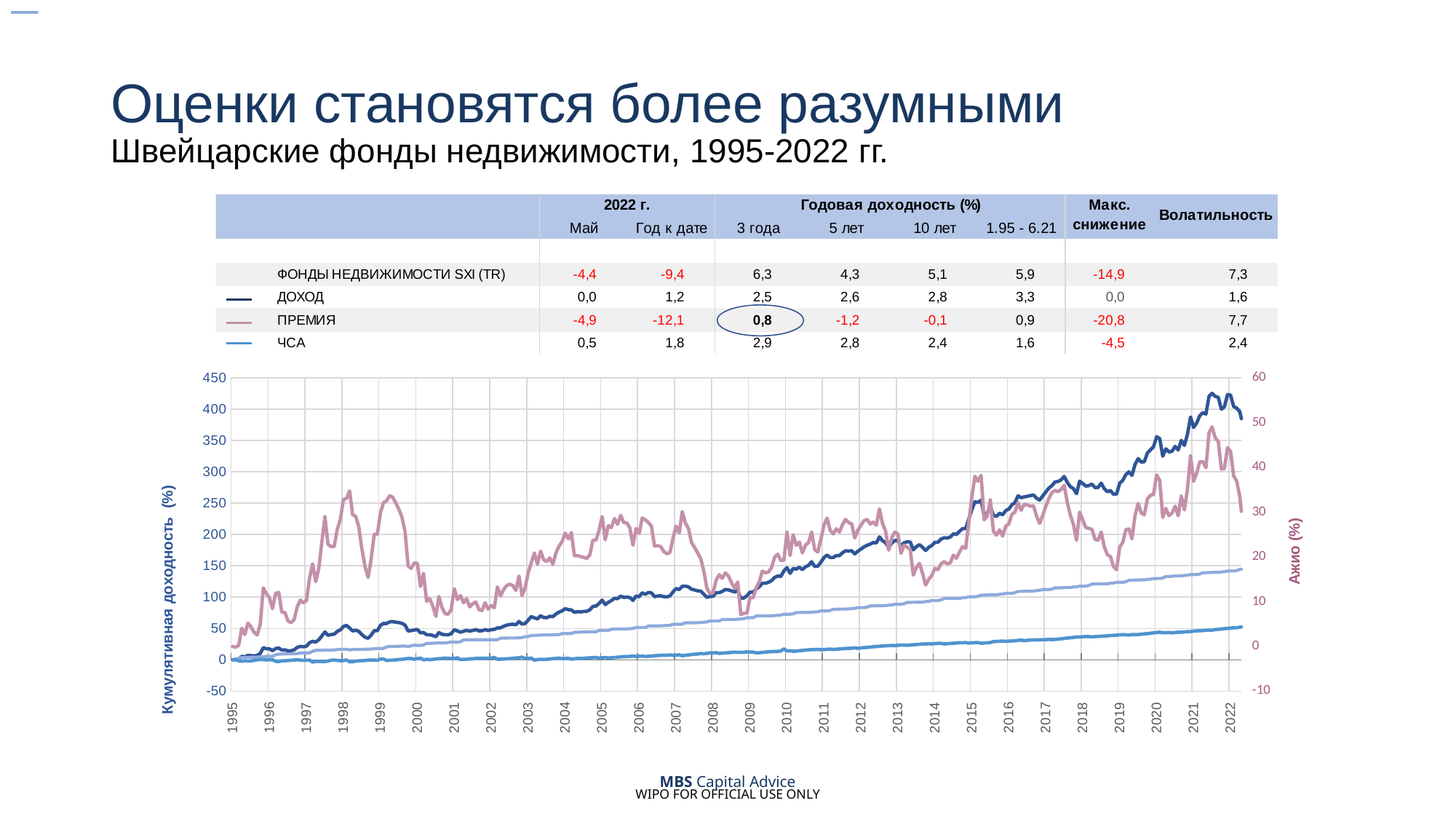
What is the title of the right vertical axis of the chart? Ажио (%) What is the highest tick value shown on the left vertical axis of the chart? 450 In the table, what is the maximum drawdown (Макс. снижение) for ПРЕМИЯ? -20,8 Is the value of the light blue ЧСА line in 2022 greater or less than 100 on the left axis? less What kind of chart is shown on the slide? line chart Is the peak value of the dark blue ДОХОД line around 2021 greater or less than 400 on the left axis? greater What is the title of the left vertical axis of the chart? Кумулятивная доходность (%) In the table, which has higher volatility (Волатильность): ПРЕМИЯ or ДОХОД? ПРЕМИЯ How many year labels are shown on the x axis of the chart? 28 What is the highest tick value shown on the right vertical axis of the chart? 60 In the table, what is the 3-year annual return (3 года) for ПРЕМИЯ? 0,8 Does the dark blue ДОХОД line overall rise or fall from 1995 to 2022? rise